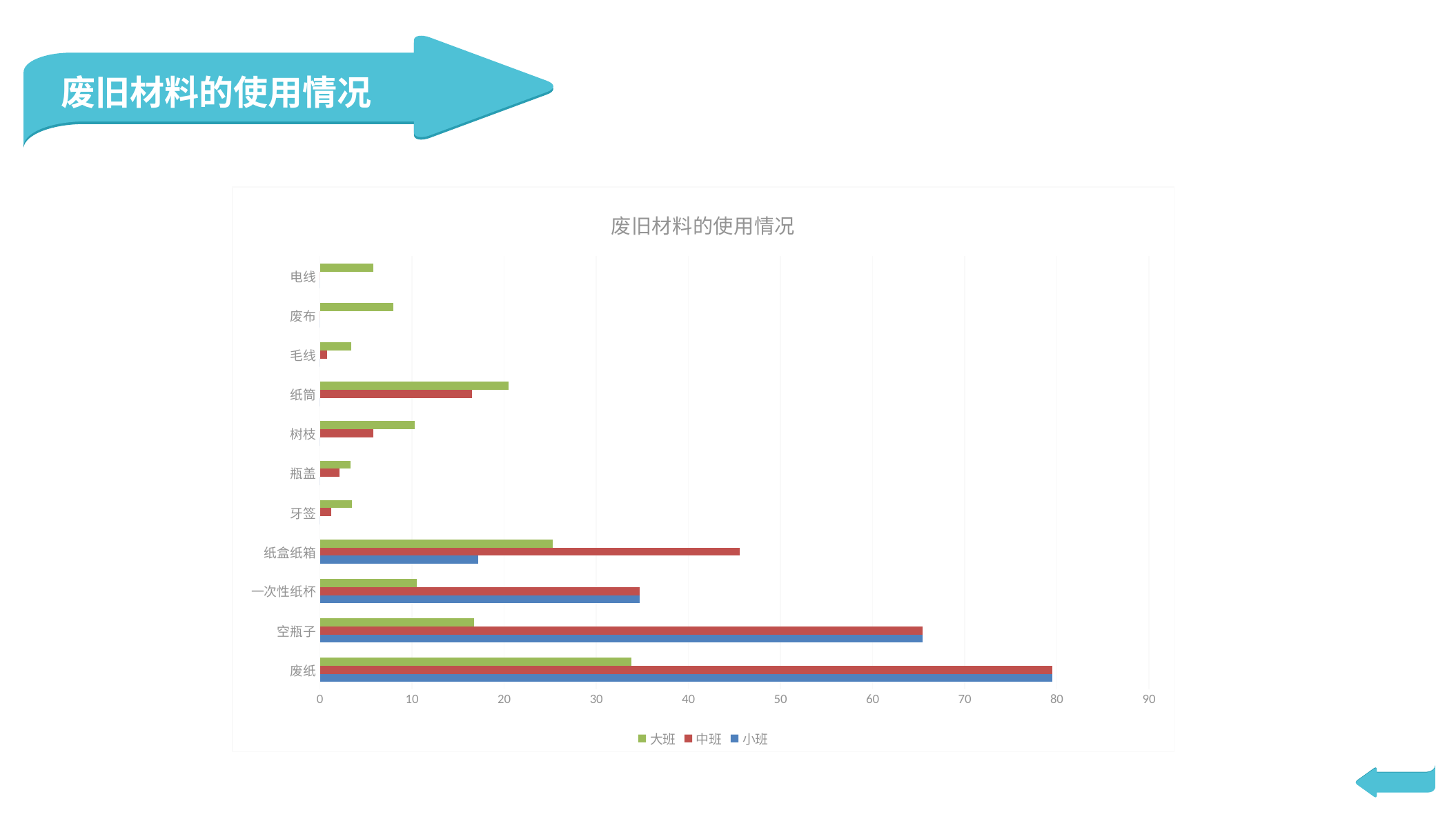
Is the 大班 value for 纸盒纸箱 greater or less than 20? greater What kind of chart is shown on the slide? bar chart Which category has the highest value for 中班? 废纸 For 纸筒, which is larger: the 大班 value or the 中班 value? 大班 For 纸盒纸箱, which is larger: the 中班 value or the 小班 value? 中班 Is the 中班 value for 废纸 greater or less than 70? greater How many series does the legend list? 3 Is the 中班 value for 空瓶子 greater or less than 60? greater Which category has the highest value for 大班? 废纸 What are the three series named in the legend? 大班, 中班, 小班 How many categories are plotted on the y axis? 11